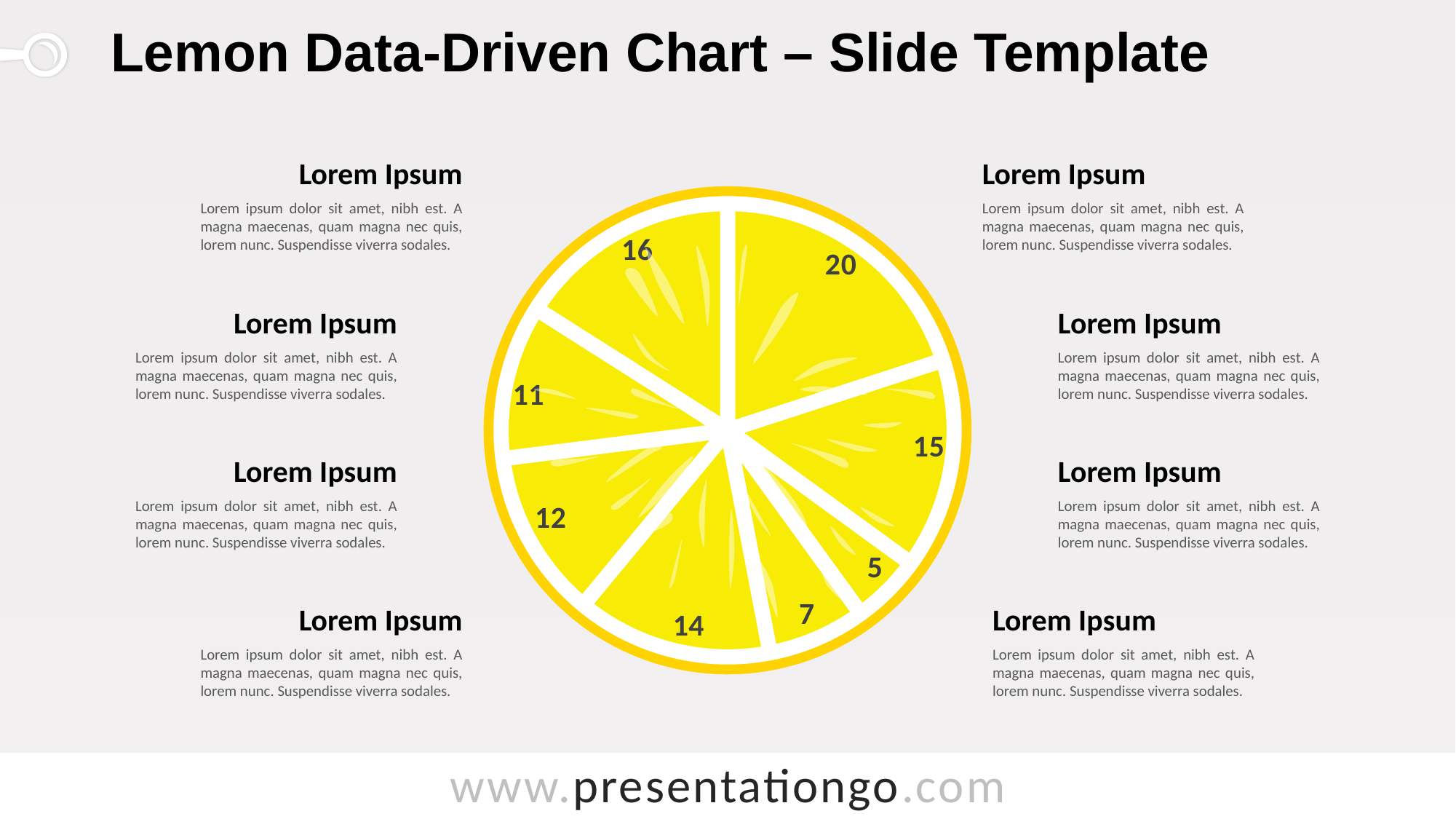
What is the largest value labelled on the pie chart? 20 What is the total of all the slice values on the pie chart? 100 What share of the whole pie does the slice labelled 5 represent? 5% How many slices on the pie chart have a value greater than 10? 6 What is the difference between the largest and smallest slice values on the pie chart? 15 How many slices does the pie chart have? 8 What is the title of the slide containing the pie chart? Lemon Data-Driven Chart – Slide Template Which is larger on the pie chart, the slice labelled 16 or the slice labelled 14? 16 What is the smallest value labelled on the pie chart? 5 What share of the whole pie does the slice labelled 20 represent? 20% What colour are the slices of the pie chart? yellow What kind of chart is shown on the slide? pie chart